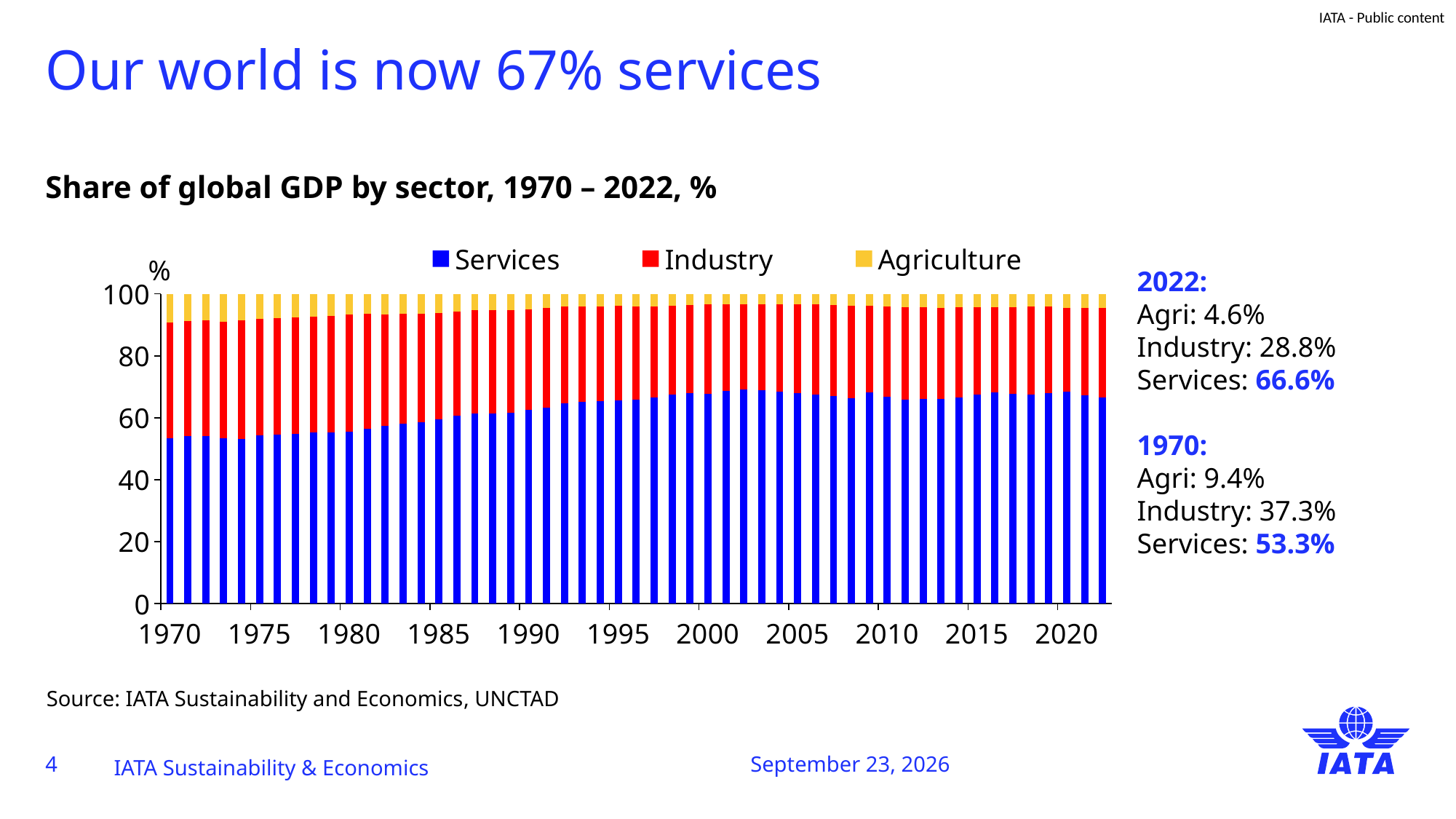
Which sector had the smallest share of global GDP in 1970? Agriculture Does the Services share of global GDP generally rise or fall from 1970 to 2022? Rise Is the Services share of global GDP in 2000 greater or less than 60? greater Which was larger in 1970, the Agriculture share or the Industry share of global GDP? Industry What was the share of global GDP for Agriculture in 2022? 4.6% What was the share of global GDP for Services in 2022? 66.6% What kind of chart is shown on the slide? Stacked bar chart By how many percentage points did the Industry share of global GDP fall from 1970 to 2022? 8.5 Which sector had the largest share of global GDP in 2022? Services By how many percentage points did the Services share of global GDP increase from 1970 to 2022? 13.3 What was the share of global GDP for Industry in 1970? 37.3% How many series does the legend list? 3